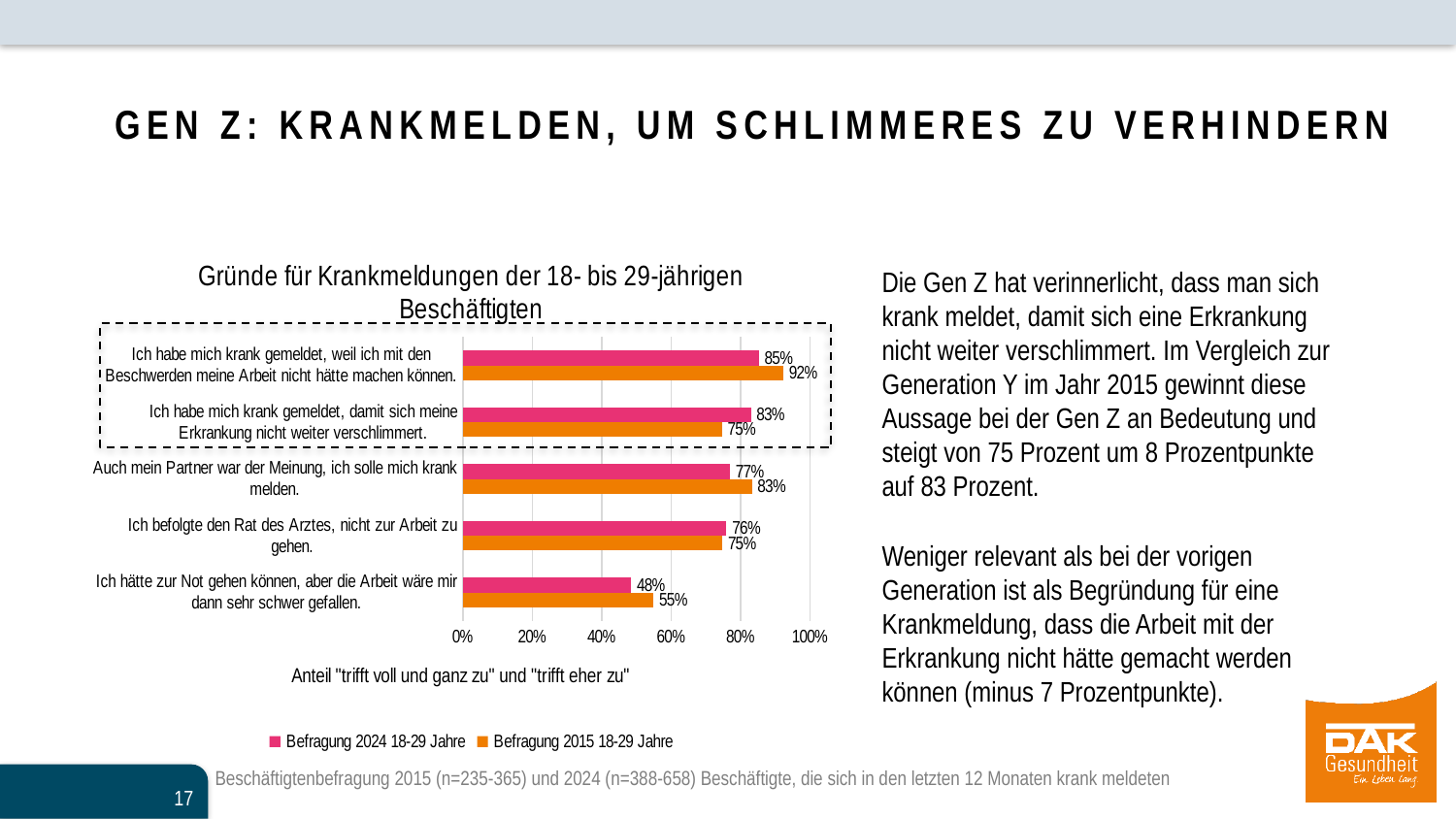
What is the value for 'Befragung 2015 18-29 Jahre' for 'Ich habe mich krank gemeldet, weil ich mit den Beschwerden meine Arbeit nicht hätte machen können.'? 92% For 'Auch mein Partner war der Meinung, ich solle mich krank melden.', which survey has the larger value, 2024 or 2015? Befragung 2015 18-29 Jahre What type of chart is shown on the slide? bar chart What is the value for 'Befragung 2024 18-29 Jahre' for 'Ich hätte zur Not gehen können, aber die Arbeit wäre mir dann sehr schwer gefallen.'? 48% Which category has the highest value for 'Befragung 2015 18-29 Jahre'? Ich habe mich krank gemeldet, weil ich mit den Beschwerden meine Arbeit nicht hätte machen können. How many series does the legend list? 2 Which category has the lowest value for 'Befragung 2024 18-29 Jahre'? Ich hätte zur Not gehen können, aber die Arbeit wäre mir dann sehr schwer gefallen. How many categories (reasons) are shown in the chart? 5 Is the 2015 value for 'Ich hätte zur Not gehen können, aber die Arbeit wäre mir dann sehr schwer gefallen.' greater or less than 60%? less What is the value for 'Befragung 2024 18-29 Jahre' for 'Ich habe mich krank gemeldet, damit sich meine Erkrankung nicht weiter verschlimmert.'? 83% What is the title of the chart? Gründe für Krankmeldungen der 18- bis 29-jährigen Beschäftigten What is the difference between the 2015 and 2024 values for 'Ich habe mich krank gemeldet, weil ich mit den Beschwerden meine Arbeit nicht hätte machen können.'? 7%